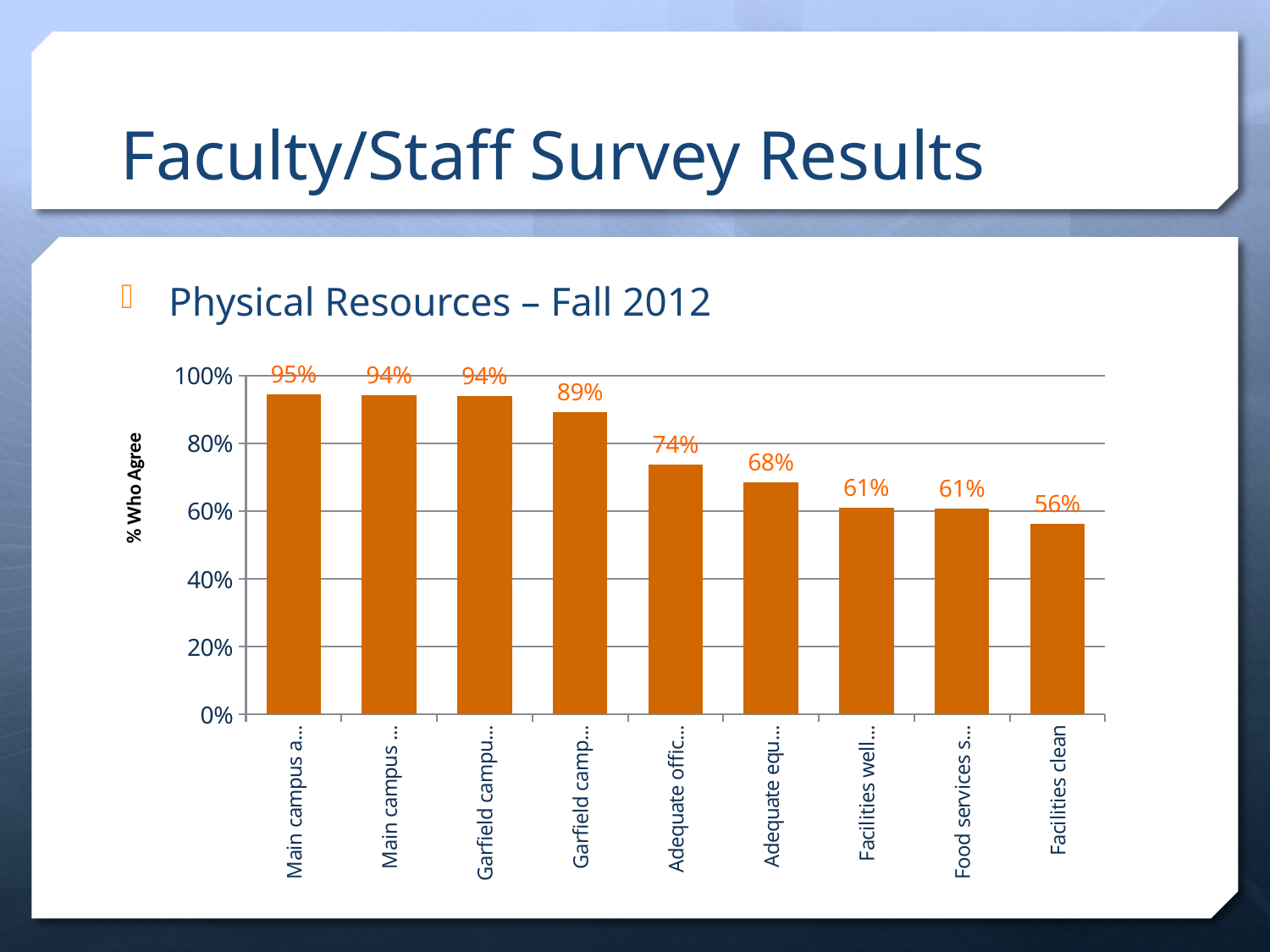
What is the value for Facilities clean? 56% What is the label on the vertical axis of the chart? % Who Agree Do the values generally rise or fall from left to right across the chart? fall Is the value for Facilities clean greater or less than 60%? less What kind of chart is shown on the slide? bar chart What is the value of the fifth bar from the left? 74% What is the value of the fourth bar from the left? 89% How many bars are plotted in the chart? 9 What is the difference between the leftmost bar (95%) and Facilities clean (56%)? 39% Which category has the lowest value in the chart? Facilities clean What is the value of the first (leftmost) bar in the chart? 95% What is the highest value shown in the chart? 95%